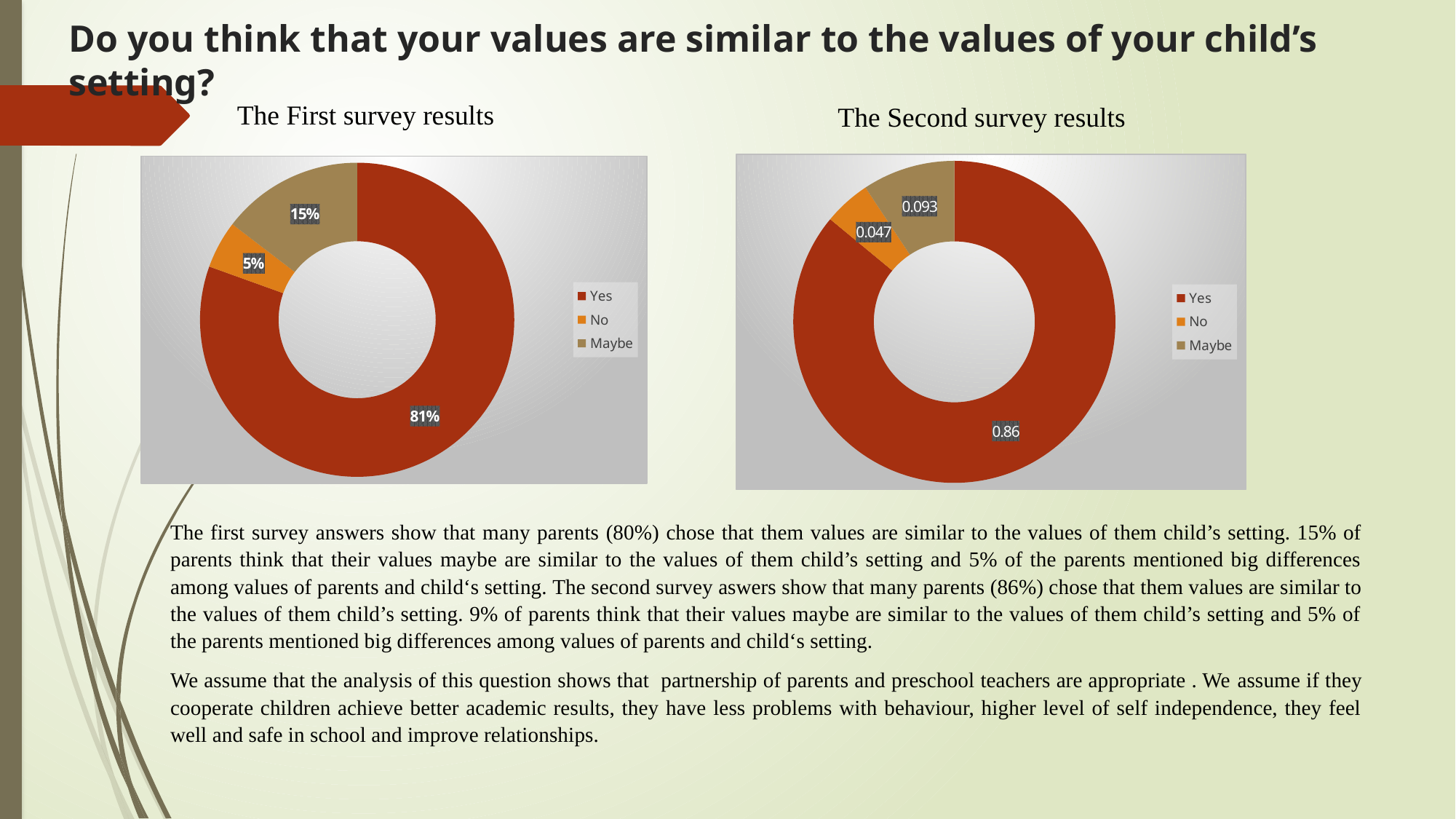
What kind of chart is the Second survey results chart? Doughnut chart In the First survey results chart, what is the value for Maybe? 15% In the First survey results chart, which category has the largest share? Yes In the First survey results chart, what is the difference between the Maybe and No values? 10% In the Second survey results chart, which is larger, Maybe or No? Maybe In the Second survey results chart, what is the value for Yes? 0.86 In the First survey results chart, what is the value for No? 5% In the First survey results chart, what is the value for Yes? 81% In the Second survey results chart, what is the value for Maybe? 0.093 In the Second survey results chart, which category has the smallest share? No In the Second survey results chart, what is the value for No? 0.047 How many categories does the legend of the First survey results chart list? 3